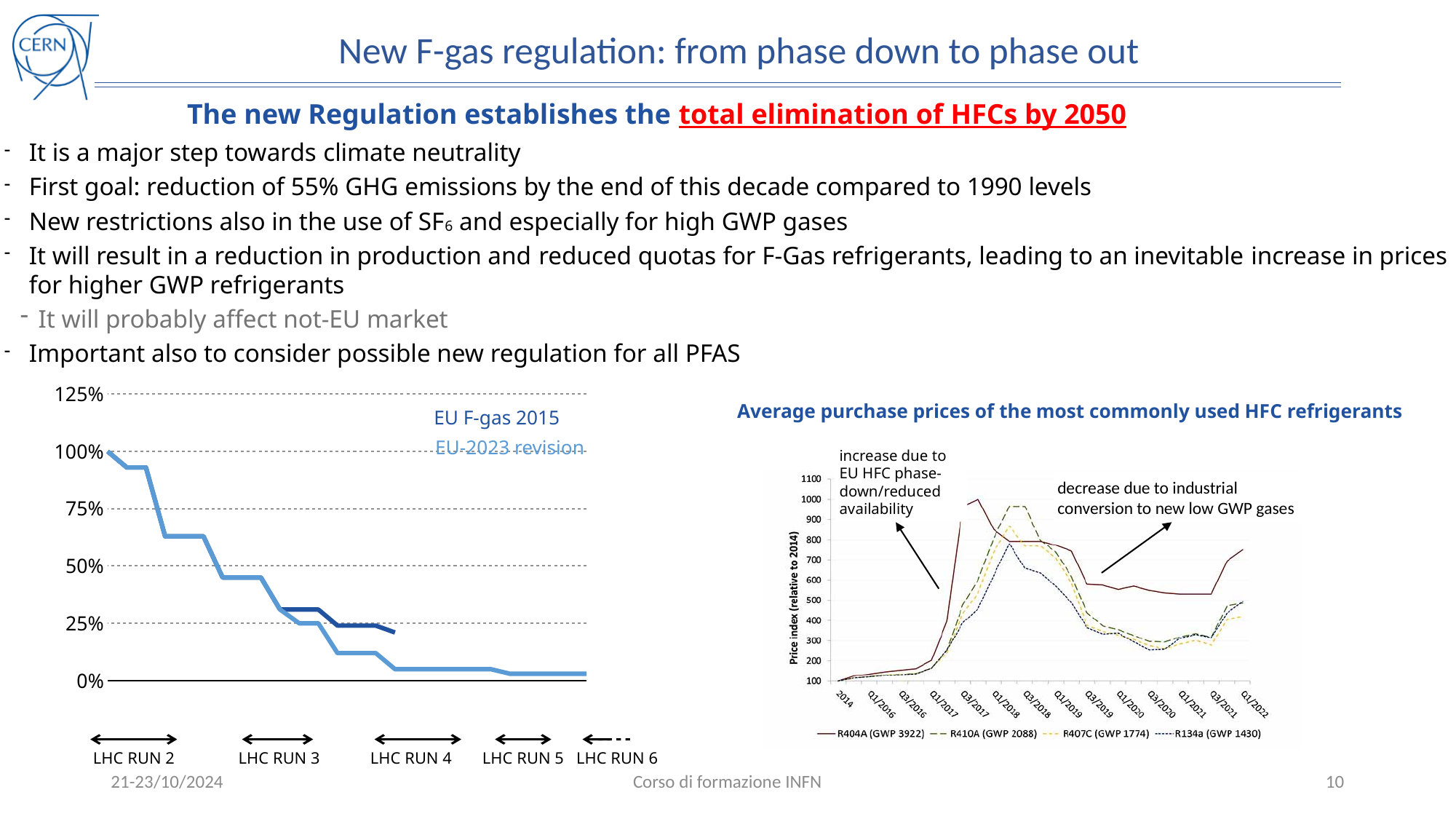
In the chart on the left, what is the starting value of the EU F-gas 2015 line? 100% In the 'Average purchase prices of the most commonly used HFC refrigerants' chart, is the value for R404A at Q1/2022 greater or less than 600? greater In the chart on the left, what is the highest value shown on the y axis? 125% In the chart on the left, do the values rise or fall along the x axis? fall In the 'Average purchase prices of the most commonly used HFC refrigerants' chart, which refrigerant has the lowest peak price index? R134a (GWP 1430) In the 'Average purchase prices of the most commonly used HFC refrigerants' chart, which refrigerant reaches the highest price index? R404A (GWP 3922) In the 'Average purchase prices of the most commonly used HFC refrigerants' chart, how many series does the legend list? 4 What is the title of the chart on the right of the slide? Average purchase prices of the most commonly used HFC refrigerants In the chart on the left, is the final value of the EU F-gas 2015 line greater or less than 25%? less What kind of chart is the chart on the left of the slide? line chart In the 'Average purchase prices of the most commonly used HFC refrigerants' chart, is the value for R134a at Q1/2022 greater or less than 600? less In the chart on the left, how many series are shown in the legend? 2